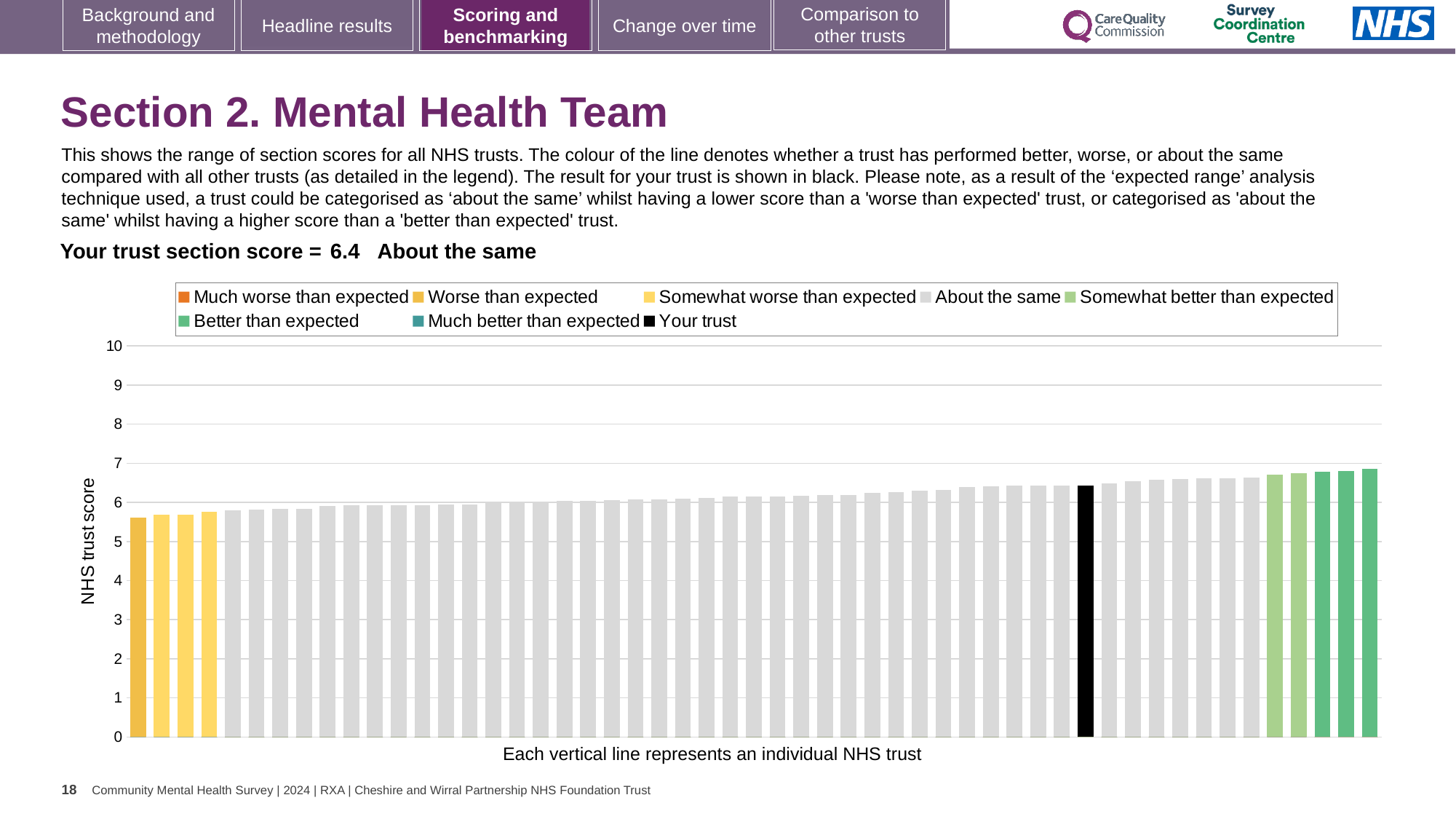
What is the label on the y axis of the chart? NHS trust score What colour is used for the bar representing your trust? black What is the section score for your trust shown on the slide? 6.4 Is the value for the lowest-scoring trust greater or less than 6? less Is the value for your trust (the black bar) greater or less than 6? greater How is your trust's section score categorised compared with other trusts? About the same Do the trust scores rise or fall from left to right along the x axis? rise Is your trust's score higher or lower than the lowest-scoring trust's score? higher What kind of chart is shown on the slide? bar chart How many entries does the chart legend list? 8 Is the value for the highest-scoring trust greater or less than 7? less